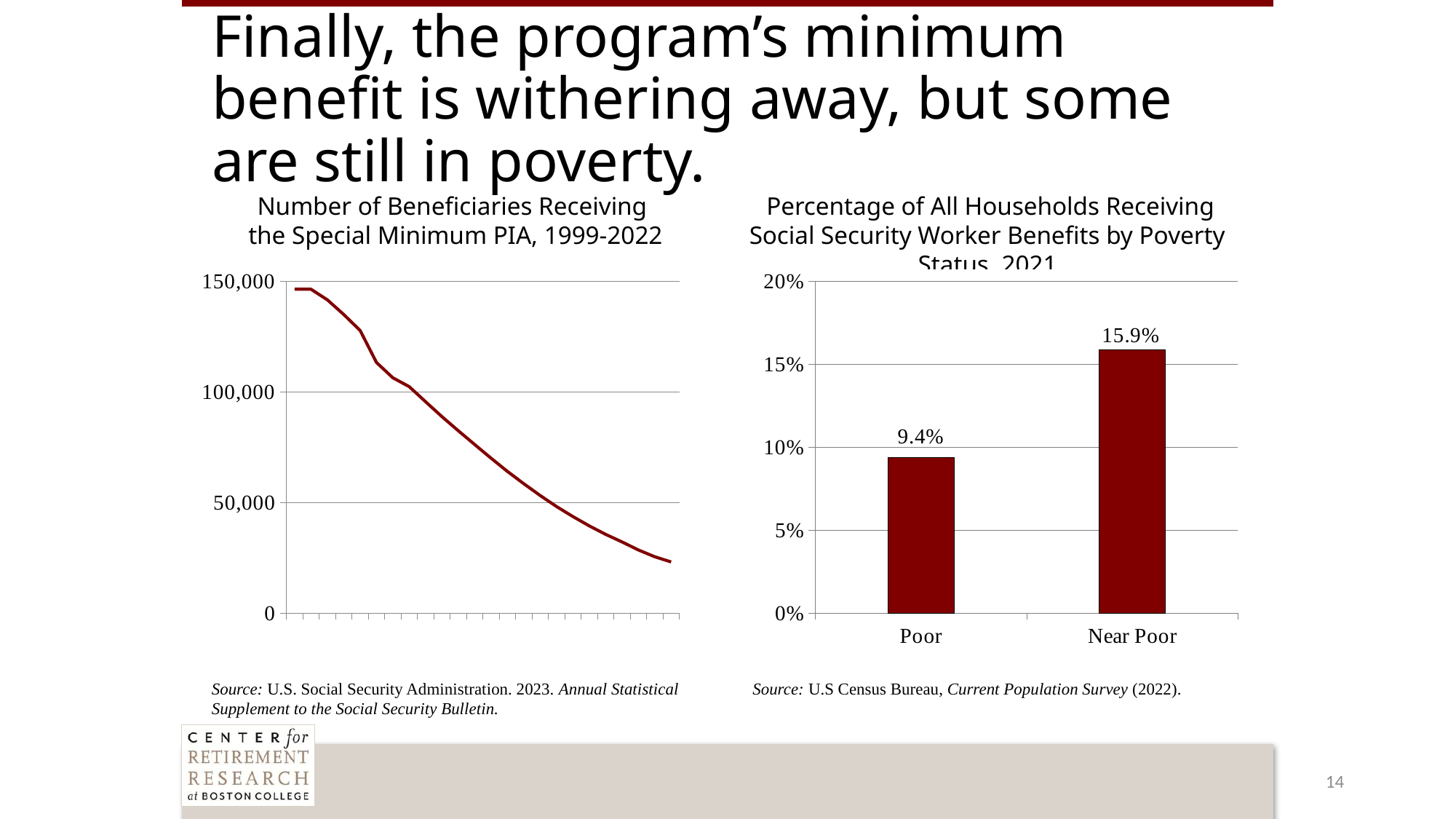
In the right-hand bar chart, which category has the lowest value? Poor In the right-hand bar chart, what is the difference between the Near Poor and Poor values? 6.5% In the right-hand bar chart, is the value for Near Poor greater or less than 15%? greater How many categories are shown in the right-hand bar chart? 2 In the right-hand bar chart, which category has the highest value? Near Poor In the chart titled 'Percentage of All Households Receiving Social Security Worker Benefits by Poverty Status, 2021', what is the value for Poor? 9.4% In the left-hand line chart, is the value at the end of the series (2022) greater or less than 50,000? less In the chart titled 'Number of Beneficiaries Receiving the Special Minimum PIA, 1999-2022', do the values rise or fall over time? Fall In the chart titled 'Percentage of All Households Receiving Social Security Worker Benefits by Poverty Status, 2021', what is the value for Near Poor? 15.9% In the left-hand line chart, is the value at the start of the series (1999) greater or less than 100,000? greater What kind of chart is the chart on the right of the slide? Bar chart What kind of chart is the chart titled 'Number of Beneficiaries Receiving the Special Minimum PIA, 1999-2022'? Line chart